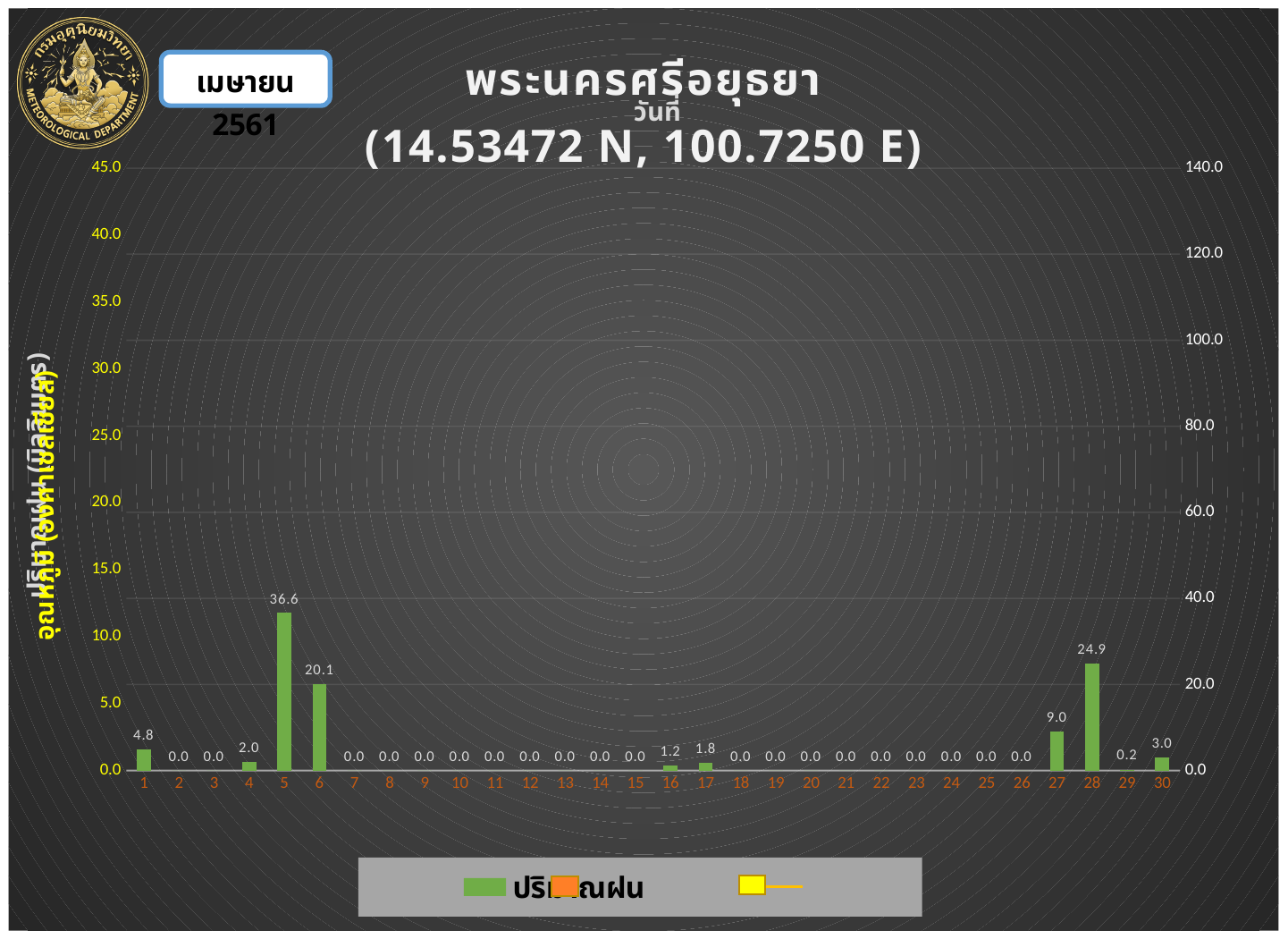
What is the rainfall value shown for day 1? 4.8 What kind of chart is shown on the slide? bar chart How many days are shown on the x axis of the chart? 30 What is the rainfall value shown for day 27? 9.0 Which day has the larger rainfall value, day 6 or day 28? 28 What is the difference between the rainfall values for day 5 and day 28? 11.7 What is the rainfall value shown for day 5? 36.6 What coordinates are given in the chart title? 14.53472 N, 100.7250 E What is the rainfall value shown for day 29? 0.2 What is the difference between the rainfall values for day 6 and day 27? 11.1 Which day has the highest rainfall value? 5 What is the rainfall value shown for day 28? 24.9